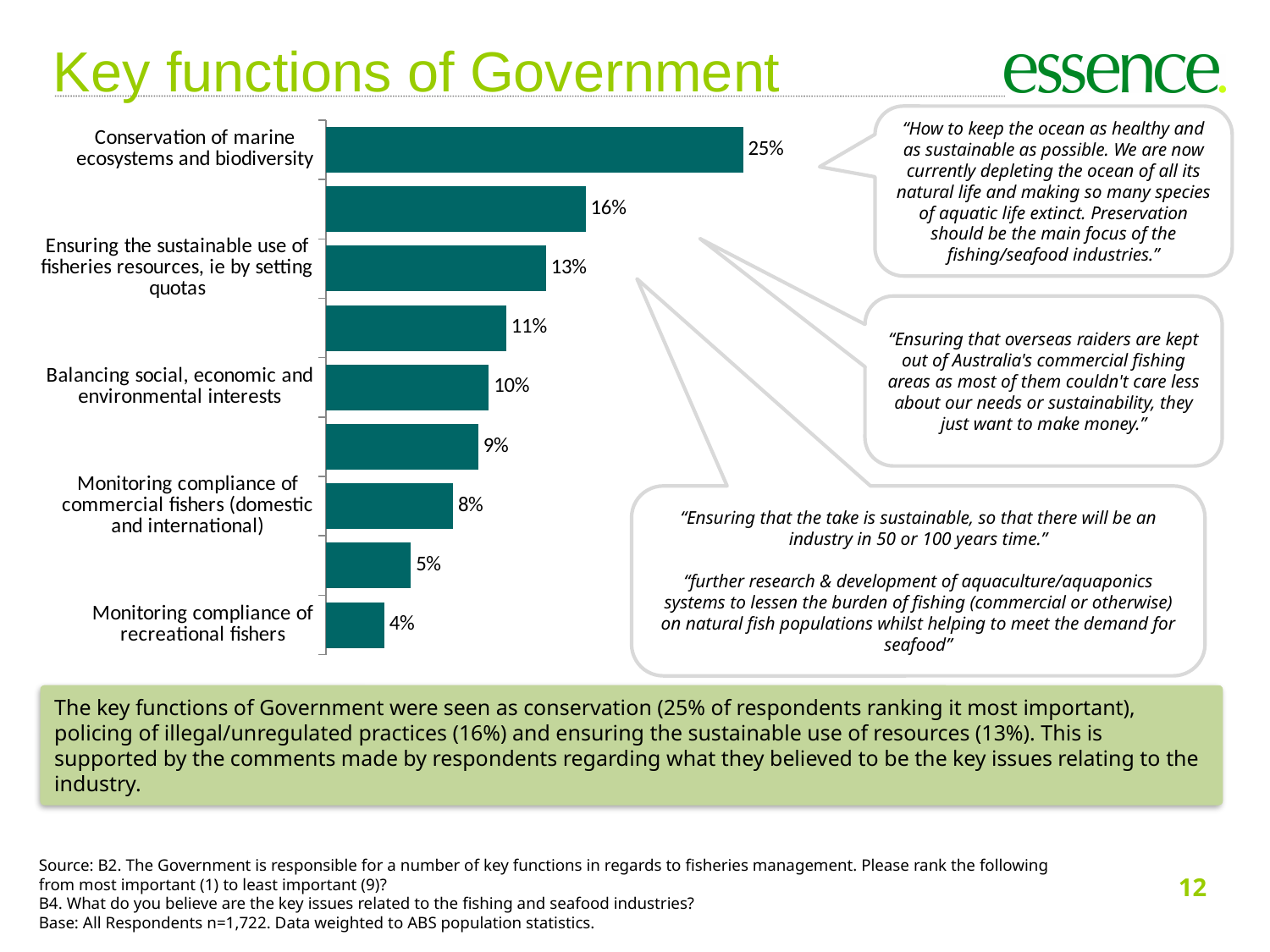
What percentage is shown for Ensuring the sustainable use of fisheries resources, ie by setting quotas? 13% Which is larger: the value for Balancing social, economic and environmental interests or the value for Monitoring compliance of commercial fishers? Balancing social, economic and environmental interests Which category has the highest value in the chart? Conservation of marine ecosystems and biodiversity Do the bar values increase or decrease from the top of the chart to the bottom? Decrease What percentage is shown for Balancing social, economic and environmental interests? 10% Which category has the lowest value in the chart? Monitoring compliance of recreational fishers What is the difference between the values for Conservation of marine ecosystems and biodiversity and Monitoring compliance of recreational fishers? 21% What percentage is shown for Monitoring compliance of recreational fishers? 4% What percentage is shown for Monitoring compliance of commercial fishers (domestic and international)? 8% What type of chart is shown on the slide? Bar chart How many bars are plotted in the chart? 9 What percentage is shown for Conservation of marine ecosystems and biodiversity? 25%